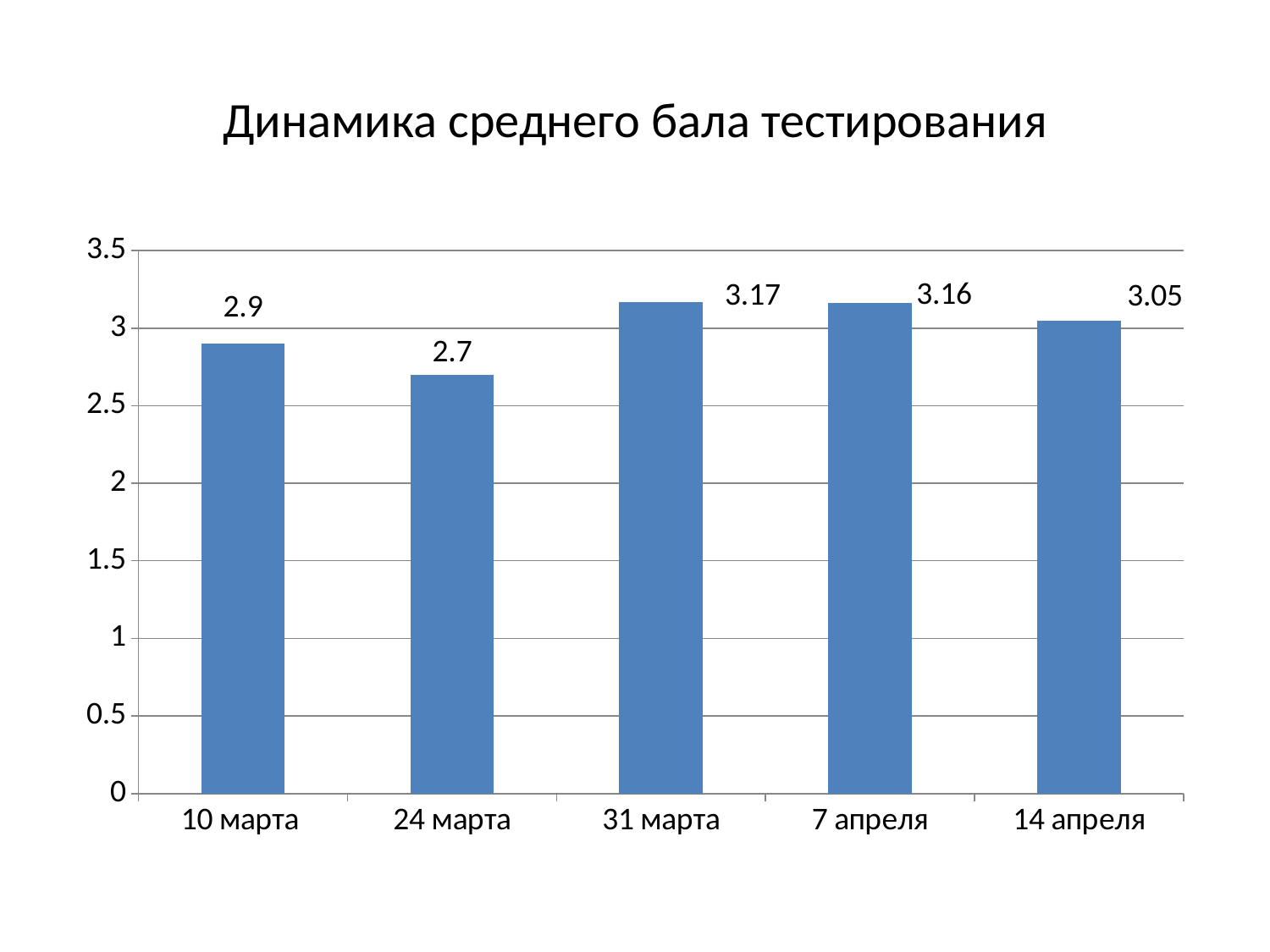
What is the value for 14 апреля? 3.05 What is the value for 24 марта? 2.7 How many dates are shown on the x axis? 5 What is the difference between the values for 31 марта and 24 марта? 0.47 What is the title of the chart? Динамика среднего бала тестирования What is the value for 31 марта? 3.17 Is the value for 24 марта greater or less than 3? less What kind of chart is shown on the slide? bar chart Which is larger, the value for 10 марта or the value for 14 апреля? 14 апреля Which date has the highest value? 31 марта What is the value for 10 марта? 2.9 Which date has the lowest value? 24 марта